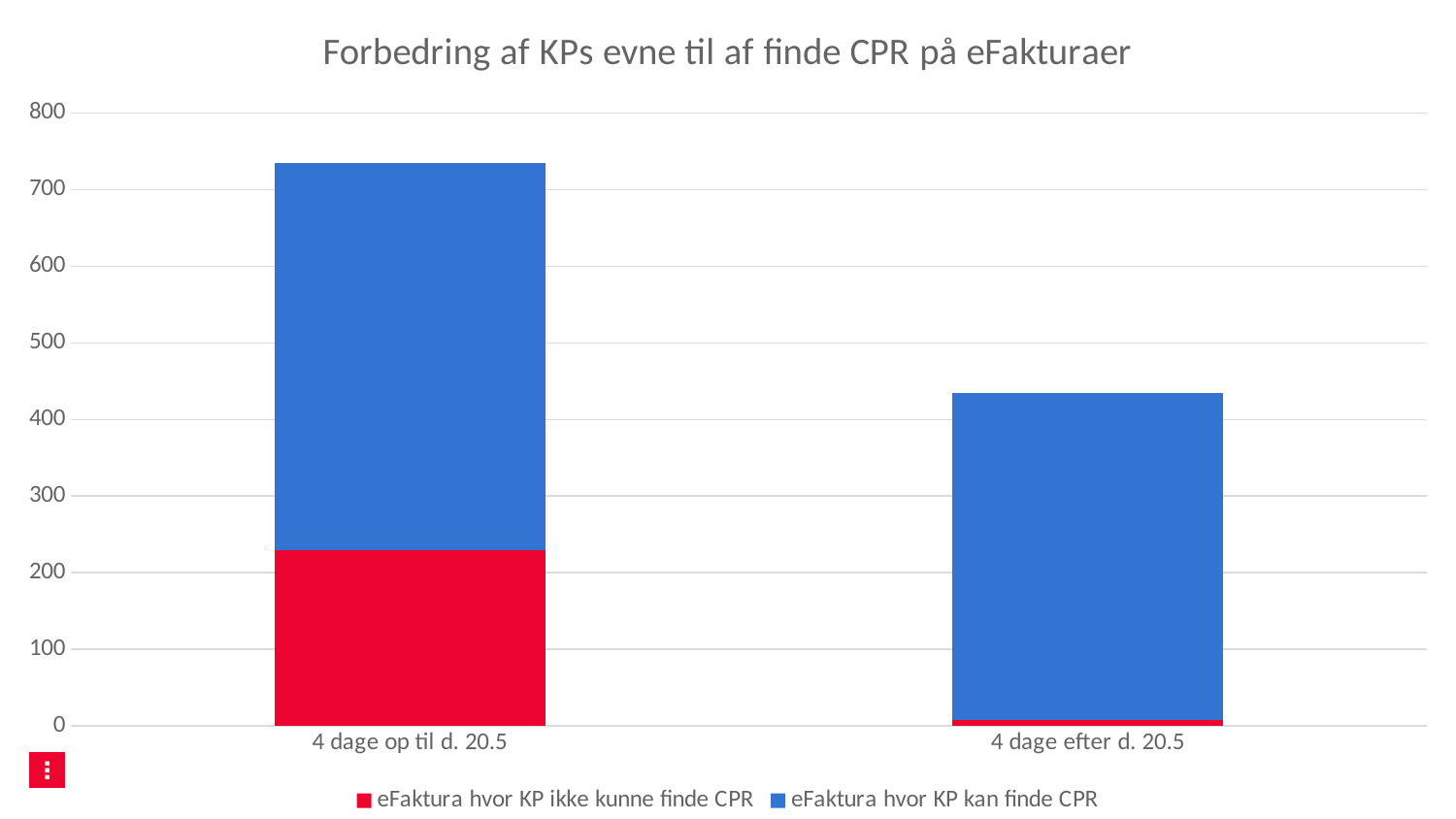
What kind of chart is shown on the slide? Stacked bar chart How many categories are shown on the x axis? 2 Is the total height of the bar for "4 dage op til d. 20.5" greater or less than 700? greater Is the "eFaktura hvor KP ikke kunne finde CPR" value for "4 dage op til d. 20.5" greater or less than 200? greater How many series does the legend list? 2 Which colour represents the series "eFaktura hvor KP ikke kunne finde CPR"? Red Is the total height of the bar for "4 dage efter d. 20.5" greater or less than 400? greater Do the total bar heights rise or fall from "4 dage op til d. 20.5" to "4 dage efter d. 20.5"? fall What is the title of the chart? Forbedring af KPs evne til af finde CPR på eFakturaer Which category has the larger "eFaktura hvor KP ikke kunne finde CPR" segment? 4 dage op til d. 20.5 Which category has the taller stacked bar, "4 dage op til d. 20.5" or "4 dage efter d. 20.5"? 4 dage op til d. 20.5